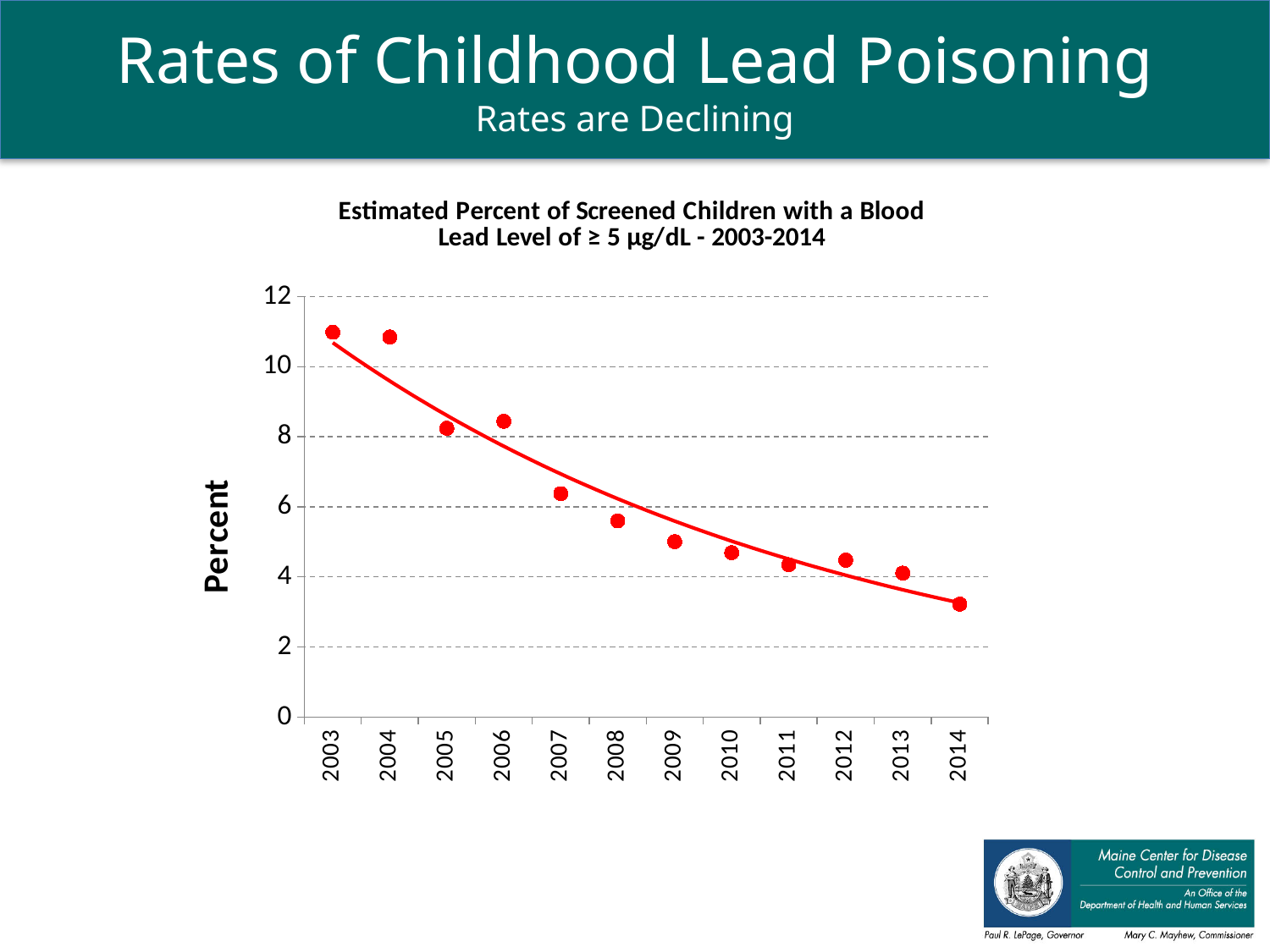
What is the label on the vertical axis? Percent Do the values rise or fall from 2003 to 2014? fall Which is larger, the value for 2005 or the value for 2010? 2005 How many data points are plotted on the chart? 12 Is the value for 2011 greater or less than 4? greater What is the title of the chart? Estimated Percent of Screened Children with a Blood Lead Level of ≥ 5 μg/dL - 2003-2014 Is the value for 2014 greater or less than 4? less Which year has the lowest value? 2014 Is the value for 2003 greater or less than 10? greater What kind of chart is shown on the slide? scatter chart